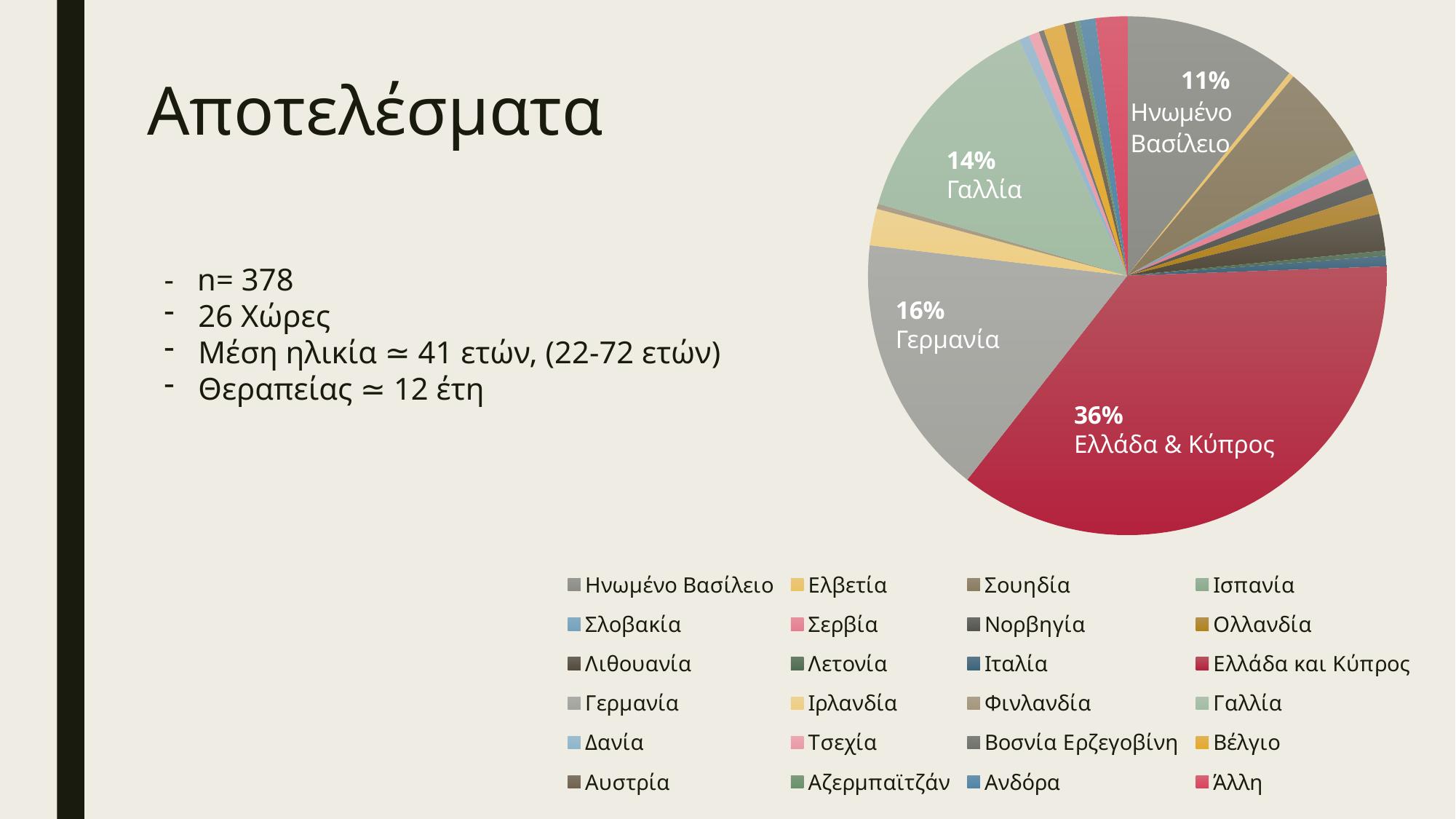
What is the title of the slide containing the pie chart? Αποτελέσματα How many entries does the legend of the pie chart list? 24 What is the difference in percentage points between the Γαλλία slice and the Ηνωμένο Βασίλειο slice? 3 percentage points What share of the pie does Ελλάδα & Κύπρος hold? 36% What share of the pie does Γαλλία hold? 14% Which category has the largest slice of the pie? Ελλάδα & Κύπρος What kind of chart is shown on the slide? pie chart What share of the pie does Ηνωμένο Βασίλειο hold? 11% Which is larger, the slice for Ελλάδα & Κύπρος or the slice for Ηνωμένο Βασίλειο? Ελλάδα & Κύπρος What is the difference in percentage points between the Ελλάδα & Κύπρος slice and the Γερμανία slice? 20 percentage points Which is larger, the slice for Γερμανία or the slice for Γαλλία? Γερμανία What share of the pie does Γερμανία hold? 16%